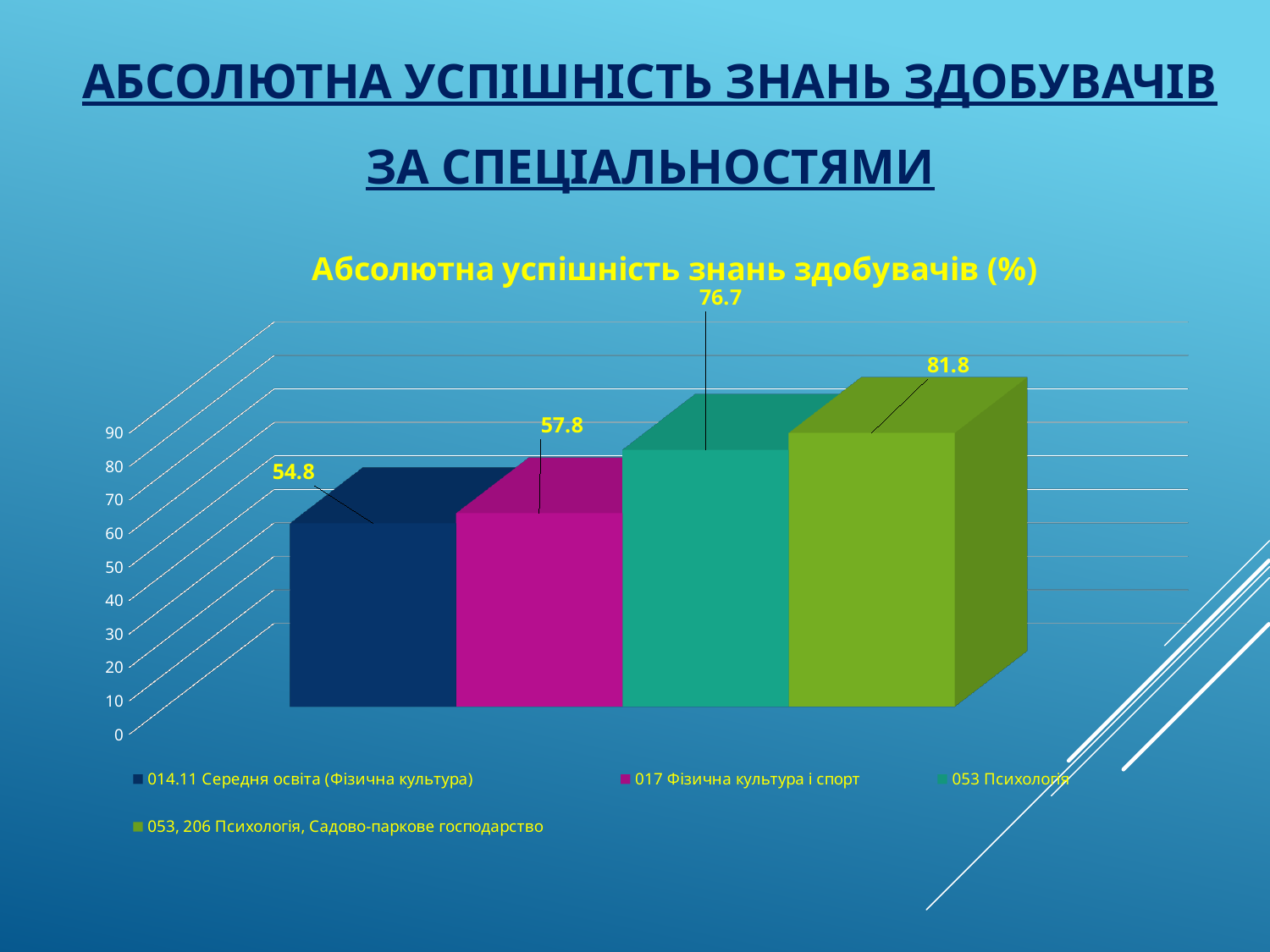
What is the value for 014.11 Середня освіта (Фізична культура)? 54.8 Which specialty has the lowest absolute success rate? 014.11 Середня освіта (Фізична культура) What is the title of the chart? Абсолютна успішність знань здобувачів (%) What is the value for 053, 206 Психологія, Садово-паркове господарство? 81.8 What is the value for 053 Психологія? 76.7 What is the difference between the values for 053 Психологія and 017 Фізична культура і спорт? 18.9 Which specialty has the highest absolute success rate? 053, 206 Психологія, Садово-паркове господарство How many bars are plotted in the chart? 4 What is the difference between the values for 053, 206 Психологія, Садово-паркове господарство and 014.11 Середня освіта (Фізична культура)? 27 What is the value for 017 Фізична культура і спорт? 57.8 Which is larger: the value for 017 Фізична культура і спорт or the value for 053 Психологія? 053 Психологія What kind of chart is shown on the slide? Bar chart